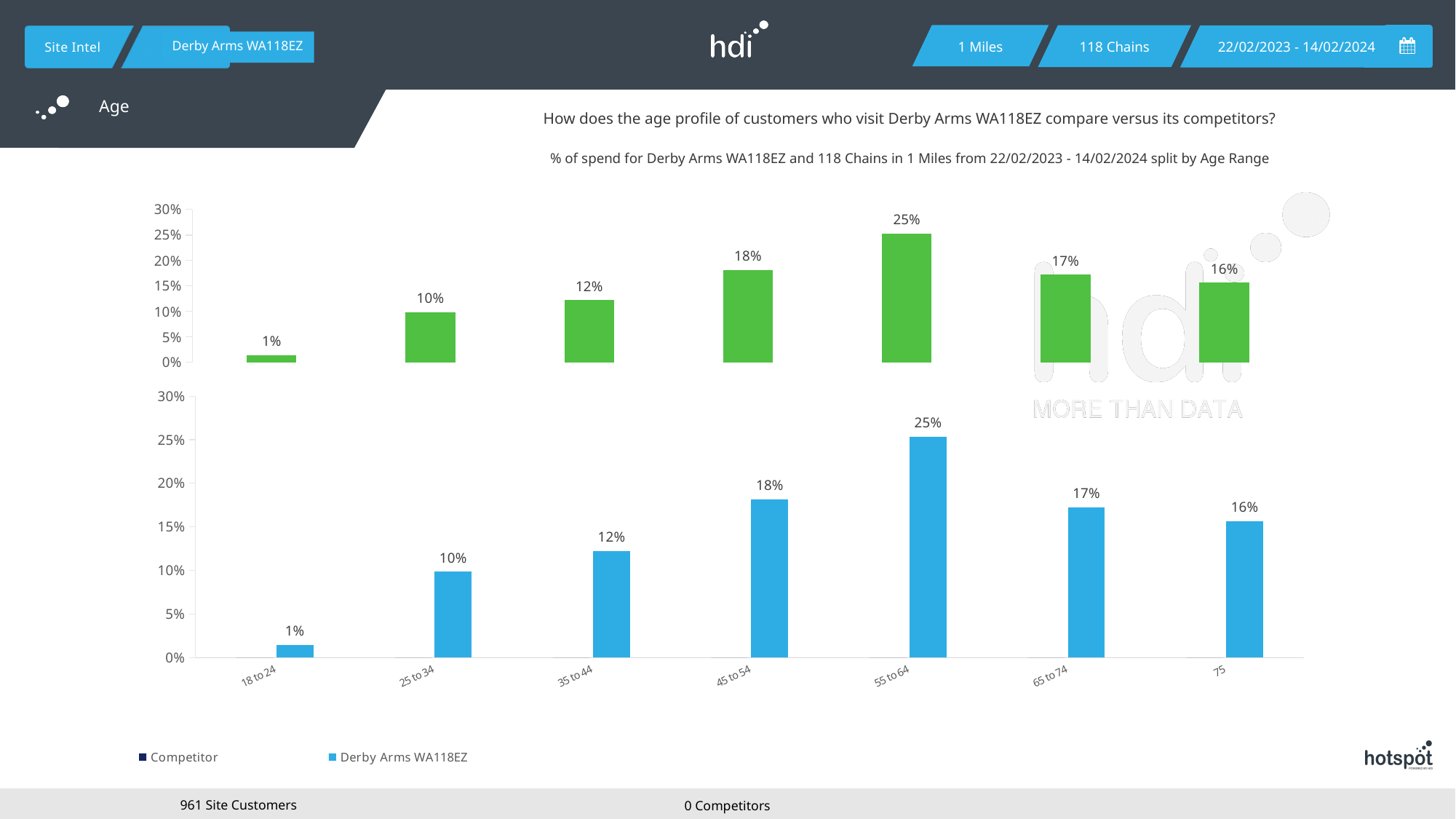
How many age range categories are shown on the x axis of the bottom chart? 7 In the bottom chart, which is larger, the value for 35 to 44 or the value for 75? 75 In the bottom chart, which age range has the highest value? 55 to 64 In the bottom chart, which age range has the lowest value? 18 to 24 In the bottom chart, what is the value for the 55 to 64 age range? 25% In the bottom chart, what is the value for the 65 to 74 age range? 17% In the bottom chart, what is the value for the 18 to 24 age range? 1% How many series does the legend list? 2 In the bottom chart, is the value for 25 to 34 greater or less than 15%? less In the bottom chart, what is the difference between the values for 55 to 64 and 45 to 54? 7% In the top chart, what is the highest value shown on the data labels? 25% What kind of chart is the bottom chart? bar chart